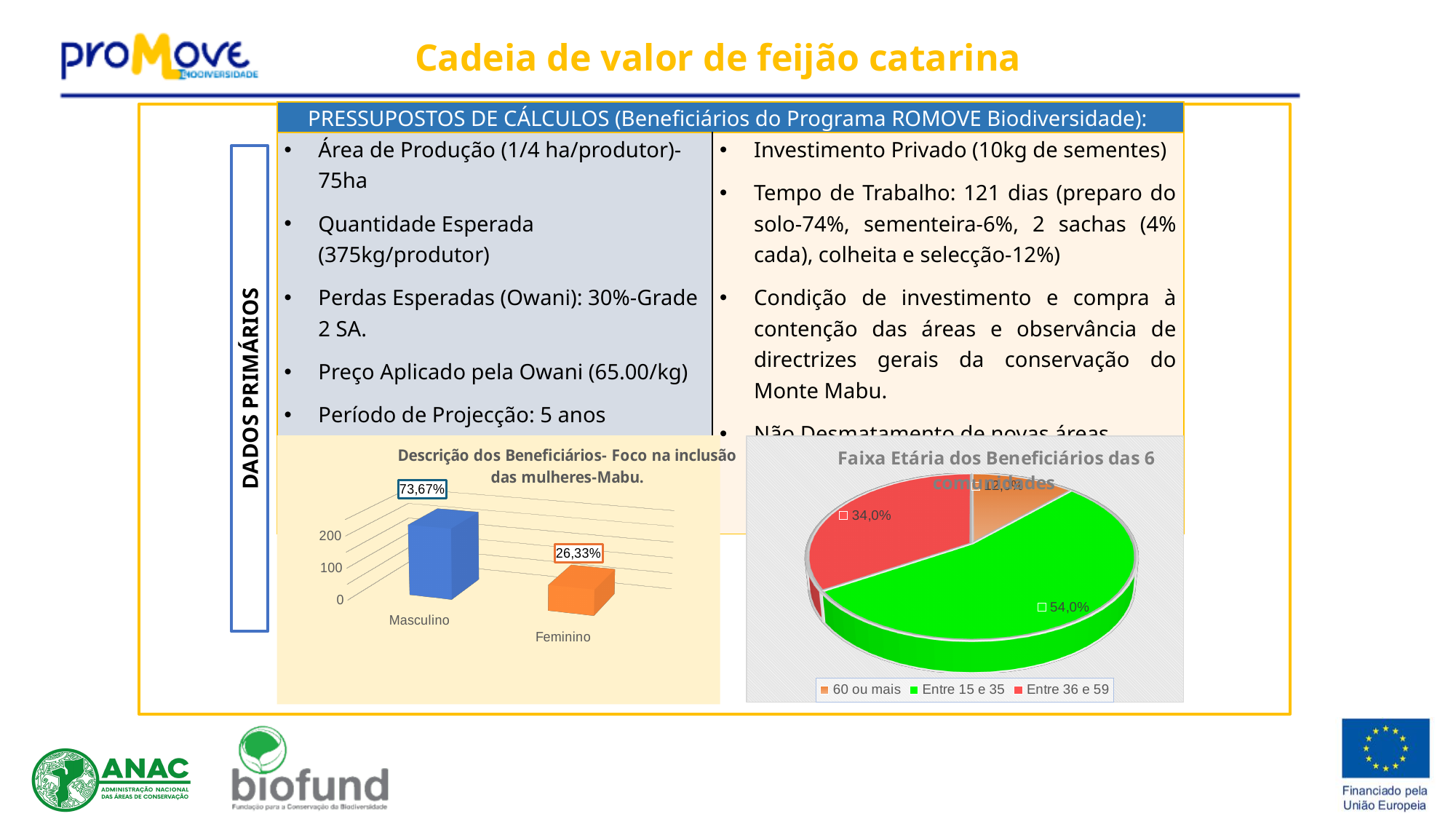
How many categories are shown in the bar chart on the left? 2 In the bar chart on the left, what is the data label shown for Masculino? 73,67% How many entries does the legend of the pie chart 'Faixa Etária dos Beneficiários das 6 comunidades' list? 3 In the pie chart 'Faixa Etária dos Beneficiários das 6 comunidades', what share is shown for 'Entre 36 e 59'? 34,0% What type of chart is the chart on the left of the slide? Bar chart In the bar chart on the left, what is the difference between the Masculino and Feminino labels? 47,34% In the pie chart 'Faixa Etária dos Beneficiários das 6 comunidades', what share is shown for '60 ou mais'? 12,0% In the pie chart 'Faixa Etária dos Beneficiários das 6 comunidades', which age group has the largest slice? Entre 15 e 35 In the bar chart on the left, which category has the higher value, Masculino or Feminino? Masculino In the pie chart 'Faixa Etária dos Beneficiários das 6 comunidades', which age group has the smallest slice? 60 ou mais In the bar chart on the left, what is the data label shown for Feminino? 26,33% In the pie chart 'Faixa Etária dos Beneficiários das 6 comunidades', what share is shown for 'Entre 15 e 35'? 54,0%